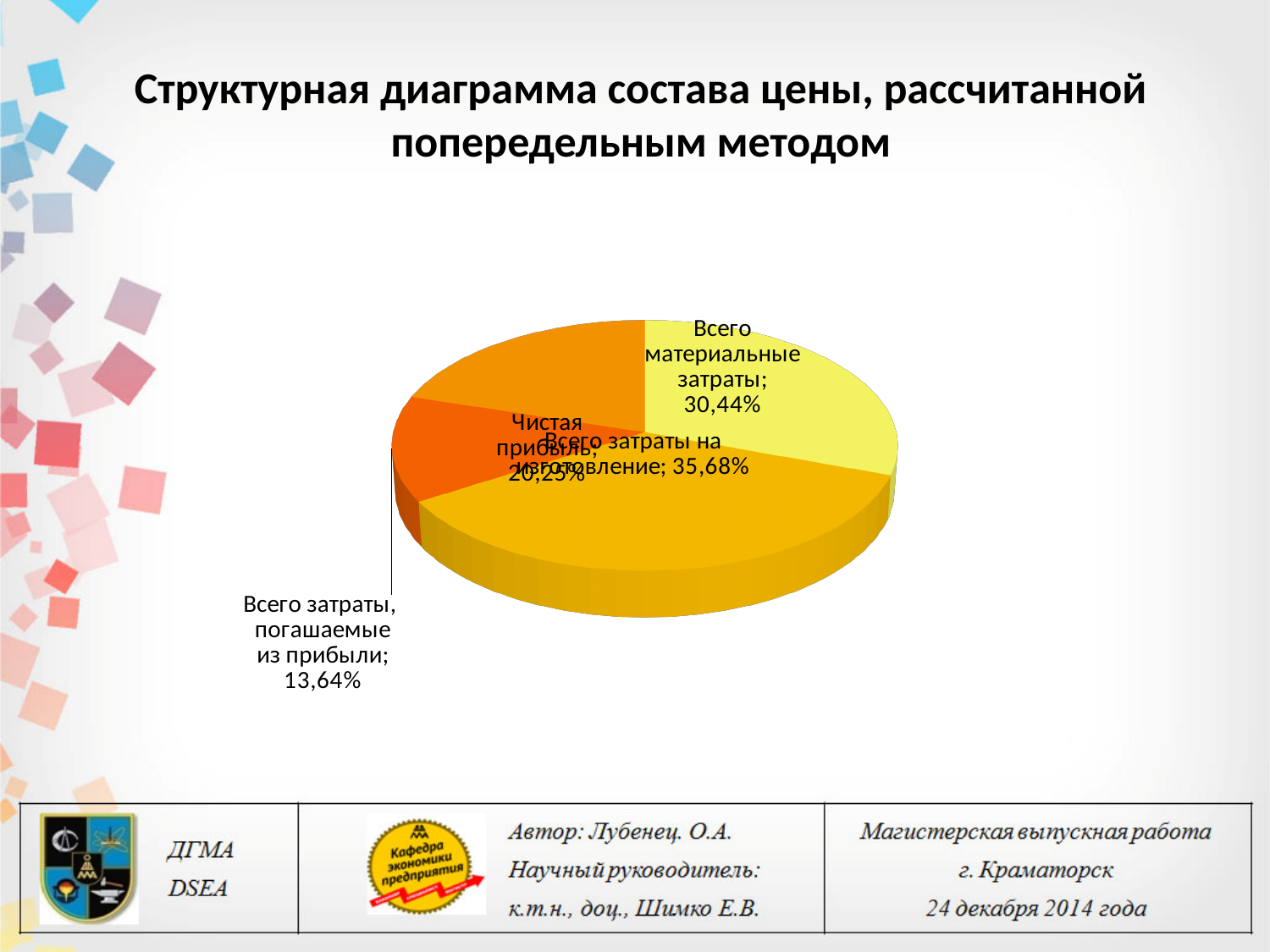
What is the title of the chart on the slide? Структурная диаграмма состава цены, рассчитанной попередельным методом What share of the pie is labelled "Чистая прибыль"? 20,25% What is the difference between the shares of "Всего материальные затраты" and "Всего затраты, погашаемые из прибыли"? 16,80% Which slice of the pie is the largest? Всего затраты на изготовление How many slices does the pie chart have? 4 Which slice of the pie is the smallest? Всего затраты, погашаемые из прибыли What share of the pie is labelled "Всего затраты, погашаемые из прибыли"? 13,64% What share of the pie is labelled "Всего материальные затраты"? 30,44% What kind of chart is shown on the slide? pie chart What is the difference between the shares of "Всего затраты на изготовление" and "Всего материальные затраты"? 5,24% Which is larger: the share of "Чистая прибыль" or the share of "Всего затраты, погашаемые из прибыли"? Чистая прибыль What share of the pie is labelled "Всего затраты на изготовление"? 35,68%